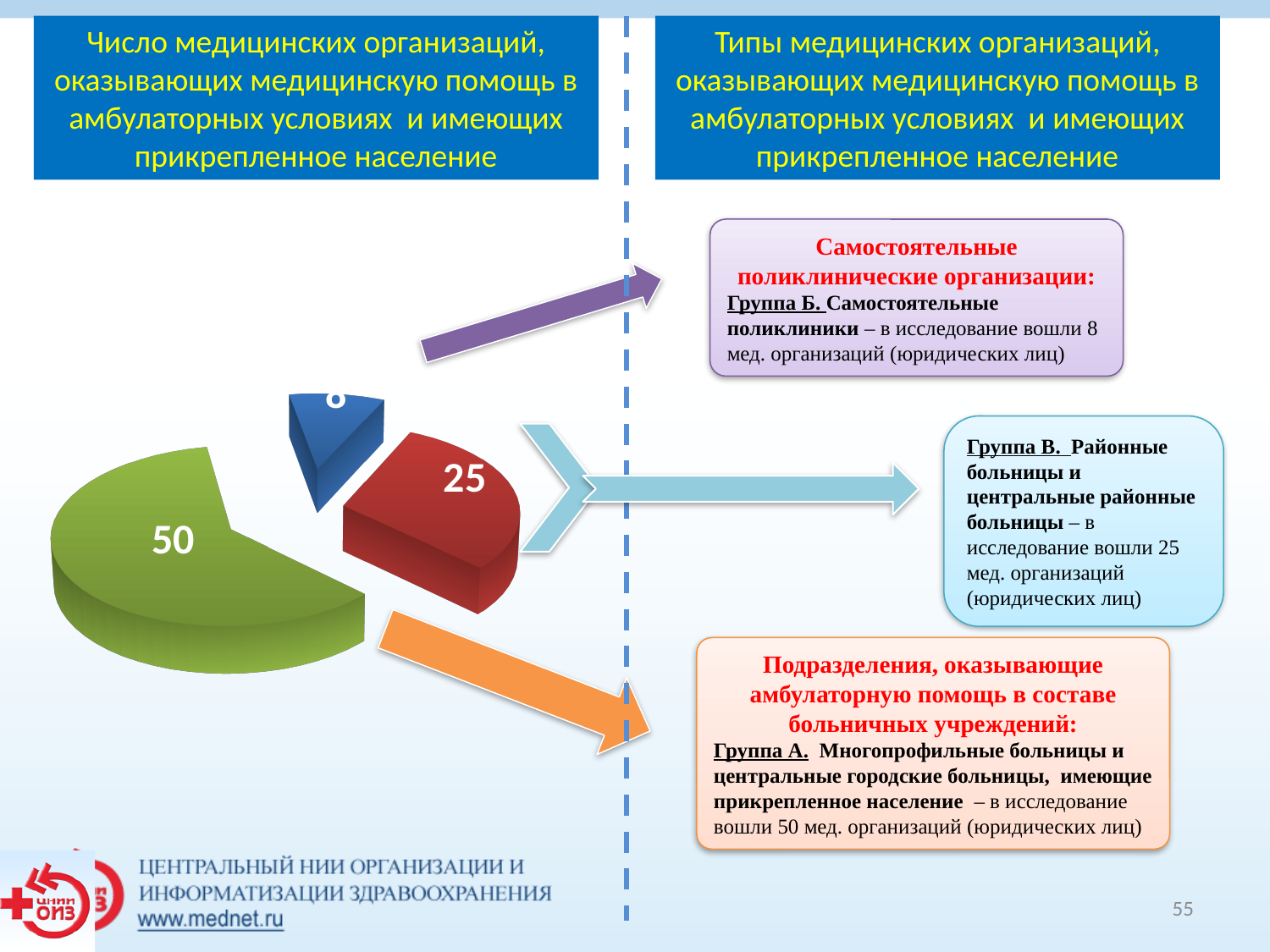
What value is labelled on the green slice of the pie chart? 50 What is the title above the pie chart on the left of the slide? Число медицинских организаций, оказывающих медицинскую помощь в амбулаторных условиях и имеющих прикрепленное население What value is labelled on the red slice of the pie chart? 25 Which slice of the pie chart is the largest? the green slice (50) Which slice of the pie chart is the smallest? the blue slice What is the difference between the green slice value and the red slice value in the pie chart? 25 What colour is the slice labelled 25 in the pie chart? red How many slices does the pie chart have? 3 Which is larger in the pie chart, the green slice or the red slice? the green slice What kind of chart is shown on the left side of the slide? pie chart